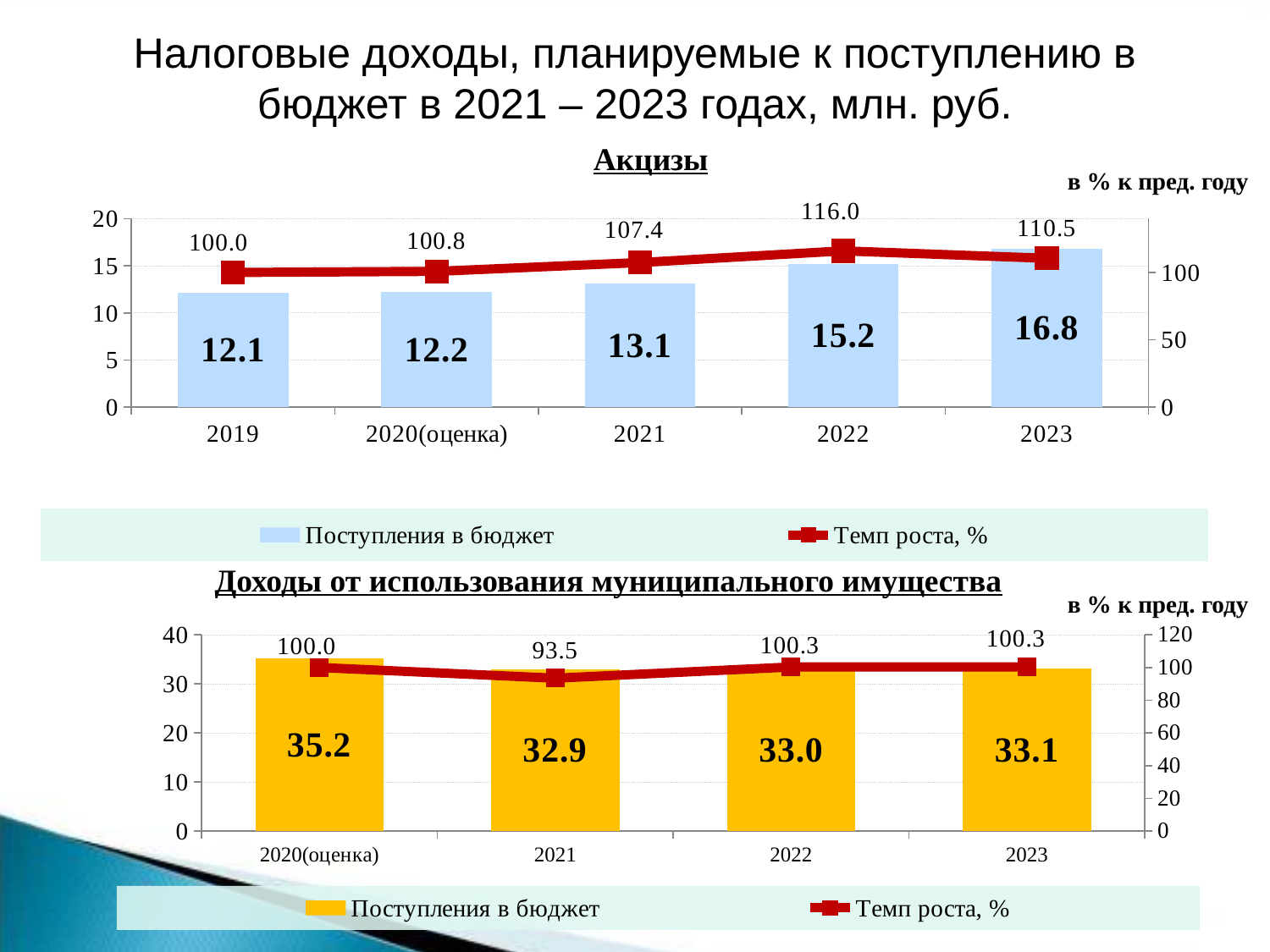
In the 'Доходы от использования муниципального имущества' chart, which year has the lowest 'Темп роста, %' value? 2021 In the 'Акцизы' chart, what is the 'Темп роста, %' value for 2021? 107.4 In the 'Акцизы' chart, which year has the highest 'Темп роста, %' value? 2022 In the 'Акцизы' chart, what is the difference between the 'Поступления в бюджет' values for 2023 and 2019? 4.7 In the 'Акцизы' chart, do the 'Поступления в бюджет' values rise or fall from 2019 to 2023? rise In the 'Акцизы' chart, which year has the highest 'Поступления в бюджет' value? 2023 In the 'Доходы от использования муниципального имущества' chart, how many series does the legend list? 2 In the 'Доходы от использования муниципального имущества' chart, what is the 'Поступления в бюджет' value for 2021? 32.9 What kind of chart is the 'Доходы от использования муниципального имущества' chart? Combined bar and line chart In the 'Акцизы' chart, what is the value of 'Поступления в бюджет' for 2022? 15.2 In the 'Доходы от использования муниципального имущества' chart, which is larger: the 'Поступления в бюджет' value for 2020(оценка) or for 2023? 2020(оценка) In the 'Акцизы' chart, how many years are shown on the x axis? 5